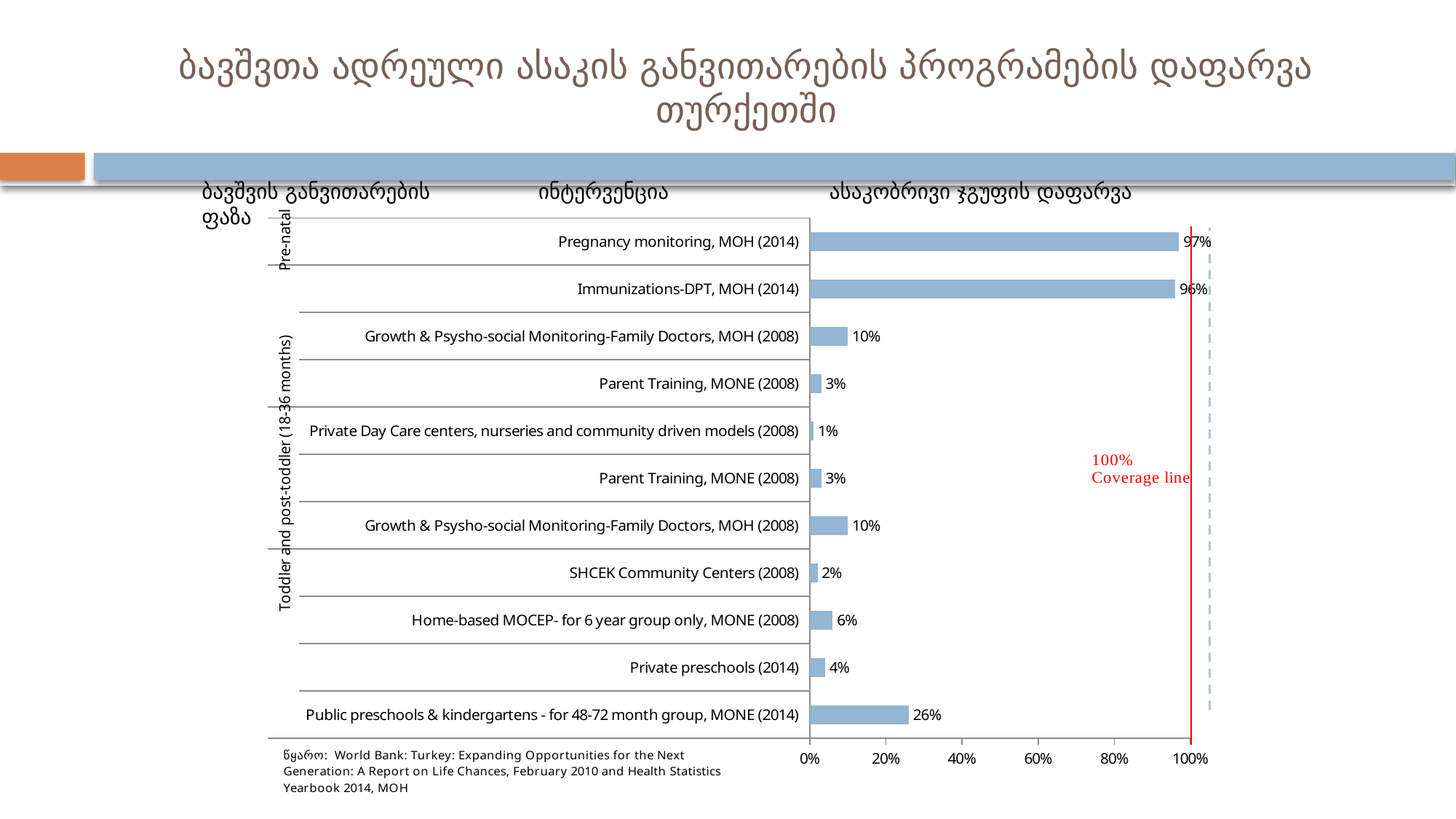
What type of chart is shown on the slide? Bar chart Which category has the highest coverage value? Pregnancy monitoring, MOH (2014) How many categories (bars) are shown in the chart? 11 What is the coverage value for Immunizations-DPT, MOH (2014)? 96% What is the coverage value for Home-based MOCEP- for 6 year group only, MONE (2008)? 6% Which category has the lowest coverage value? Private Day Care centers, nurseries and community driven models (2008) What is the difference between the coverage for Public preschools & kindergartens - for 48-72 month group, MONE (2014) and Private preschools (2014)? 22% Which has a larger coverage value: SHCEK Community Centers (2008) or Private preschools (2014)? Private preschools (2014) Is the coverage value for Public preschools & kindergartens - for 48-72 month group, MONE (2014) greater or less than 20%? greater What is the difference between the coverage for Pregnancy monitoring, MOH (2014) and Immunizations-DPT, MOH (2014)? 1% What is the coverage value for Pregnancy monitoring, MOH (2014)? 97% What is the coverage value for Public preschools & kindergartens - for 48-72 month group, MONE (2014)? 26%